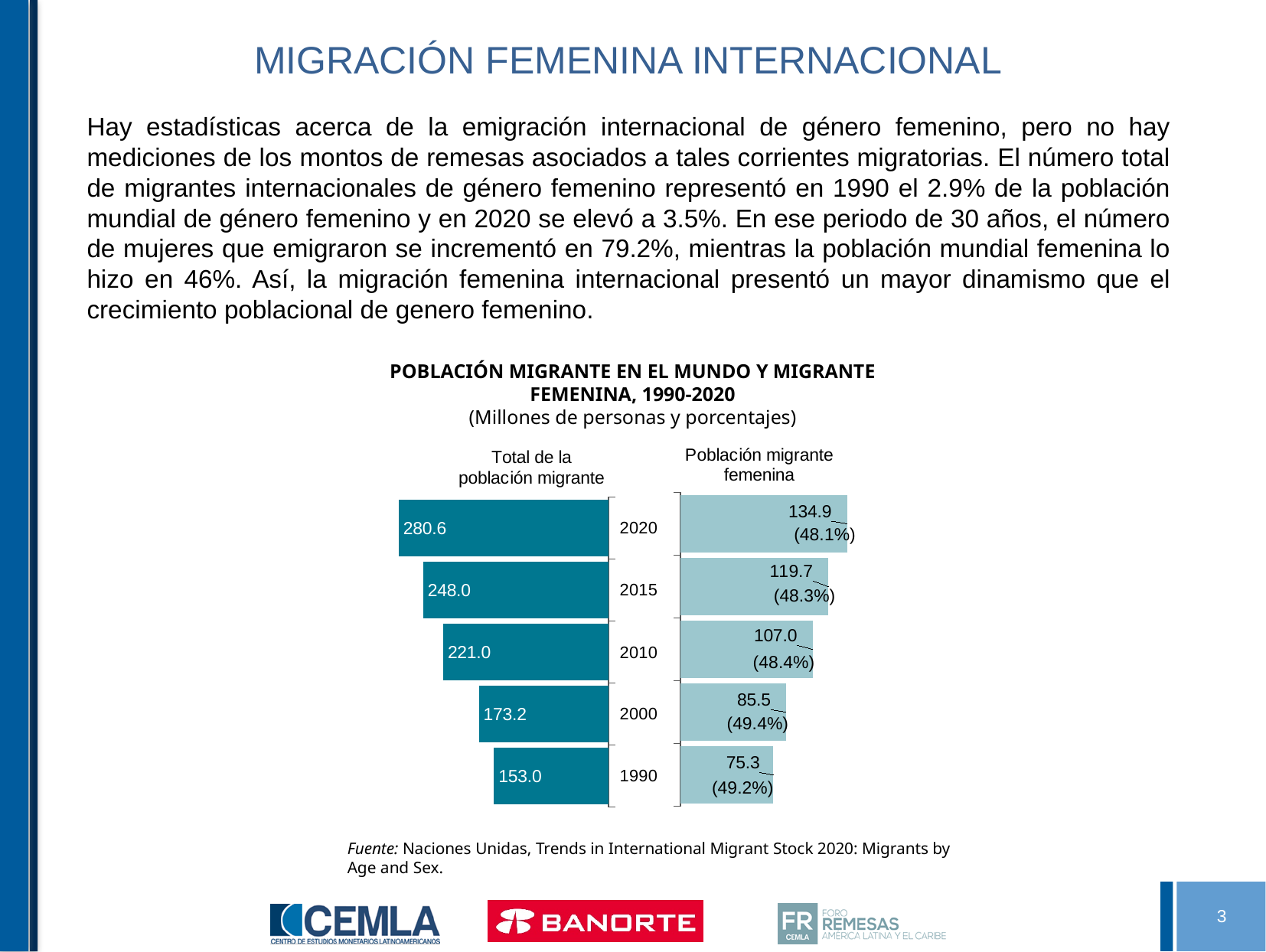
Does the female migrant population rise or fall from 1990 to 2020? Rise What type of chart is used to show the migrant population data? Bar chart Which year shows the lowest female migrant population? 1990 What percentage share of the migrant population was female in 2010? 48.4% How many years are shown in the chart? 5 What was the total migrant population in 2020 according to the chart? 280.6 What is the title of the chart? POBLACIÓN MIGRANTE EN EL MUNDO Y MIGRANTE FEMENINA, 1990-2020 What is the difference between the female migrant population in 2015 and in 2010? 12.7 Which is larger: the total migrant population in 2000 or in 2010? 2010 Which year shows the highest total migrant population? 2020 By how much did the total migrant population increase between 1990 and 2020? 127.6 What was the female migrant population in 1990? 75.3